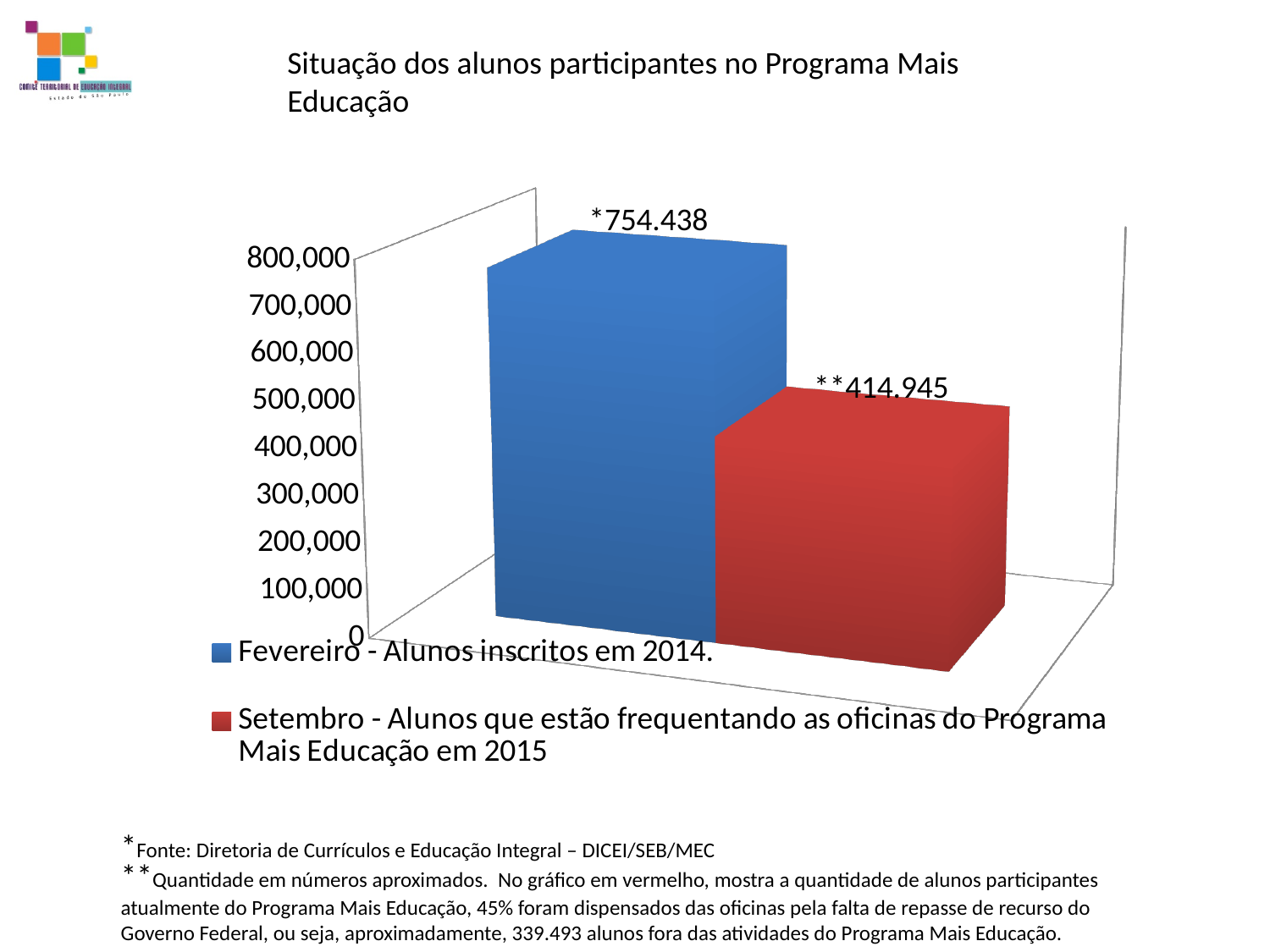
What is the title of the chart? Situação dos alunos participantes no Programa Mais Educação Which series has the higher value, Fevereiro or Setembro? Fevereiro - Alunos inscritos em 2014. How many series does the legend list? 2 What is the difference between the Fevereiro value and the Setembro value? 339.493 Is the value for the red bar (Setembro) greater or less than 500,000? less Is the value for Fevereiro larger or smaller than the value for Setembro? larger Which series has the lower value? Setembro - Alunos que estão frequentando as oficinas do Programa Mais Educação em 2015 What value is shown for the blue bar, Fevereiro - Alunos inscritos em 2014? 754.438 What value is shown for the red bar, Setembro - Alunos que estão frequentando as oficinas do Programa Mais Educação em 2015? 414.945 How many bars are plotted in the chart? 2 Is the value for the blue bar (Fevereiro) greater or less than 700,000? greater What kind of chart is shown on the slide? bar chart